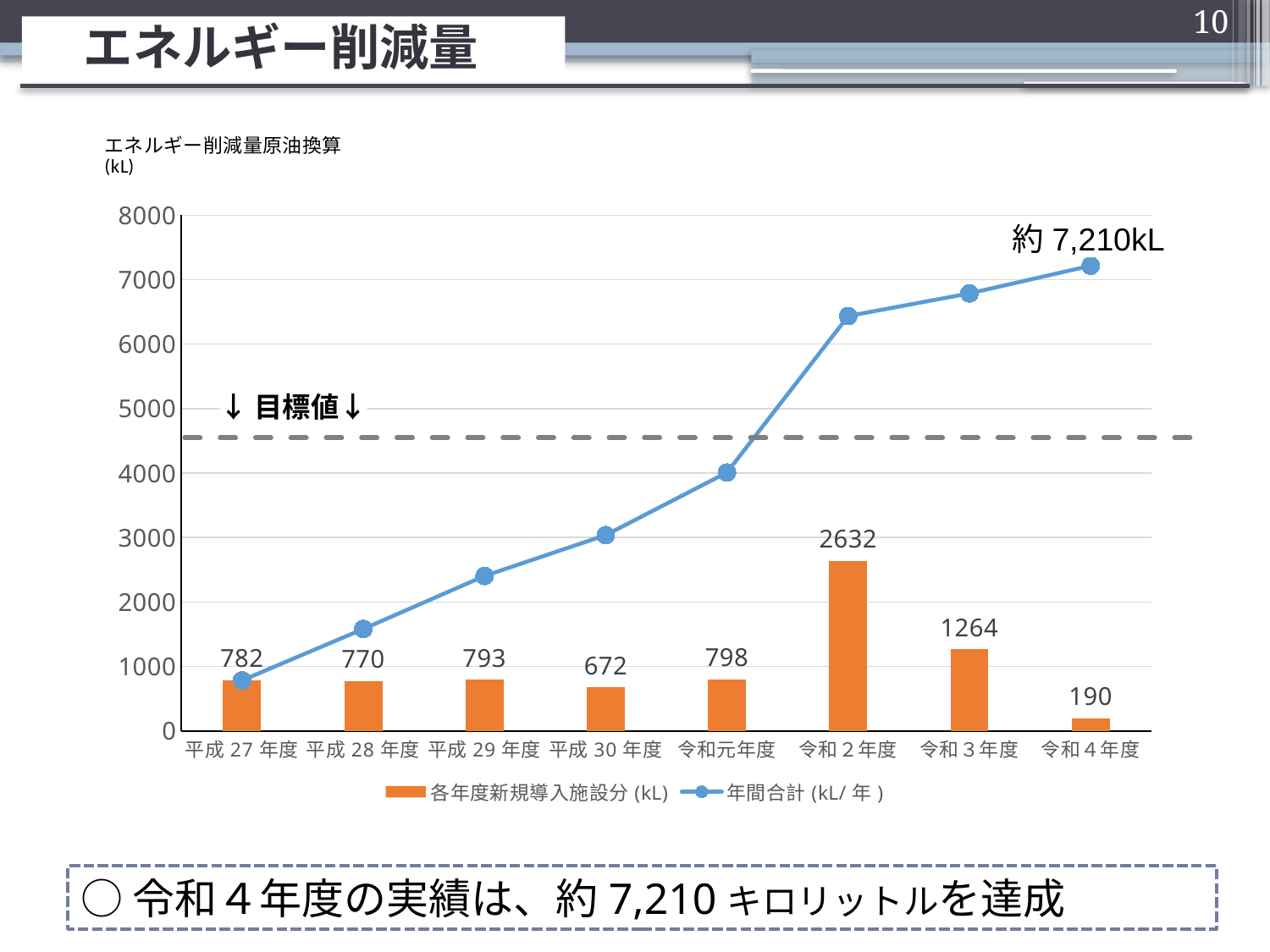
Is the 年間合計 value for 令和２年度 greater or less than 6000? greater How many series does the legend list? 2 What value is labelled on the 年間合計 line for 令和４年度? 約 7,210kL What is the value of the 各年度新規導入施設分 bar for 令和２年度? 2632 Which year has the highest 各年度新規導入施設分 bar? 令和２年度 What is the value of the 各年度新規導入施設分 bar for 平成 30 年度? 672 Is the 年間合計 value for 平成 29 年度 greater or less than 2000? greater Which is larger, the 各年度新規導入施設分 value for 平成 29 年度 or for 平成 30 年度? 平成 29 年度 Does the 年間合計 line rise or fall from 平成 27 年度 to 令和４年度? rise What is the difference between the 各年度新規導入施設分 values for 令和２年度 and 令和３年度? 1368 Which year has the lowest 各年度新規導入施設分 bar? 令和４年度 How many fiscal years are shown on the x axis? 8